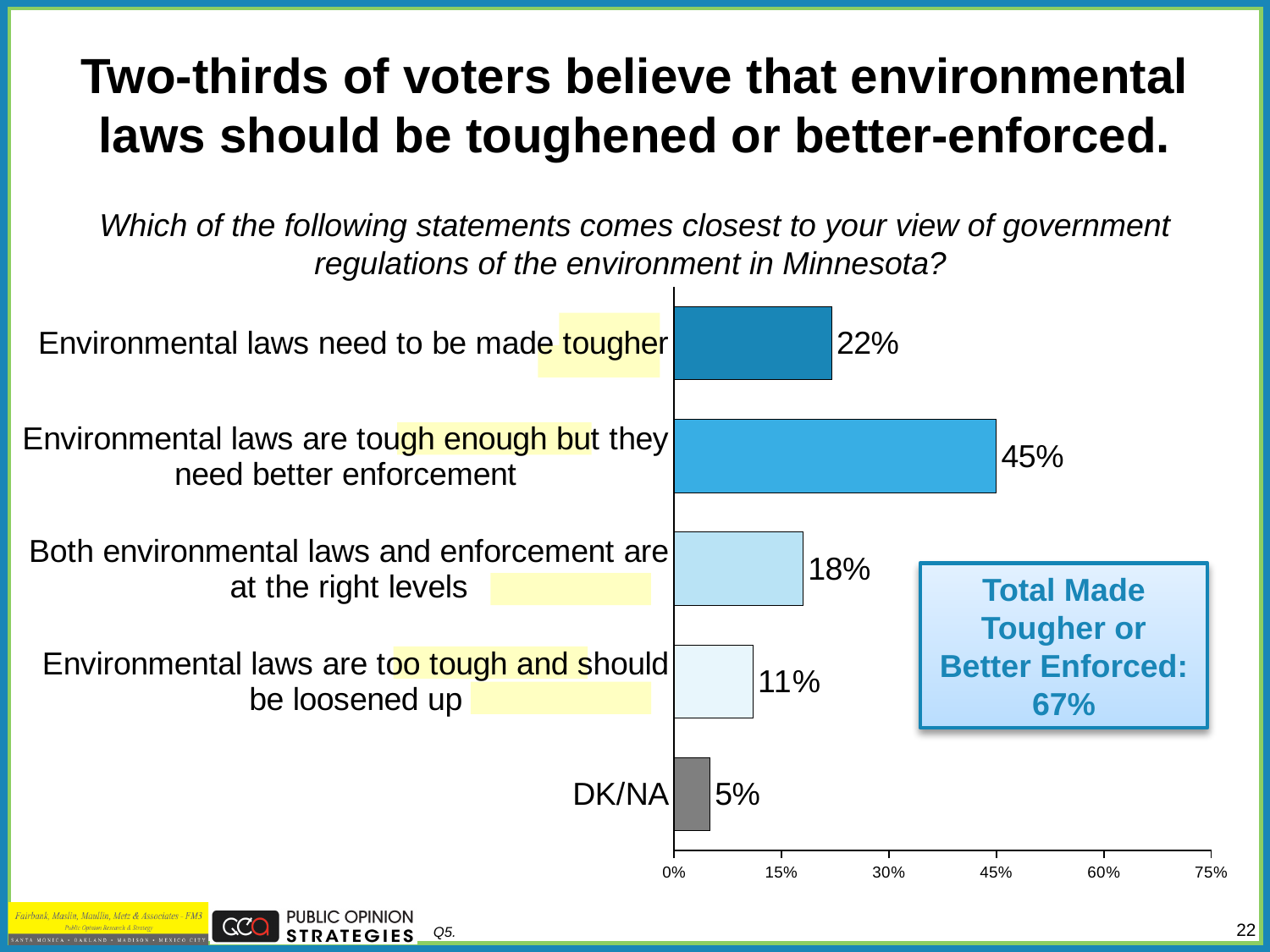
What type of chart is shown on the slide? Bar chart What percentage of voters say environmental laws are tough enough but need better enforcement? 45% What is the difference between the percentage saying laws are tough enough but need better enforcement and the percentage saying laws need to be made tougher? 23% What percentage of voters say both environmental laws and enforcement are at the right levels? 18% What percentage of voters say environmental laws need to be made tougher? 22% Which is larger: the percentage saying laws and enforcement are at the right levels, or the percentage saying laws are too tough and should be loosened up? Both environmental laws and enforcement are at the right levels Which response has the lowest percentage? DK/NA Which response has the highest percentage? Environmental laws are tough enough but they need better enforcement What percentage of voters say environmental laws are too tough and should be loosened up? 11% How many response categories are shown in the chart? 5 What is the value for DK/NA? 5% What total percentage does the callout box give for 'Total Made Tougher or Better Enforced'? 67%